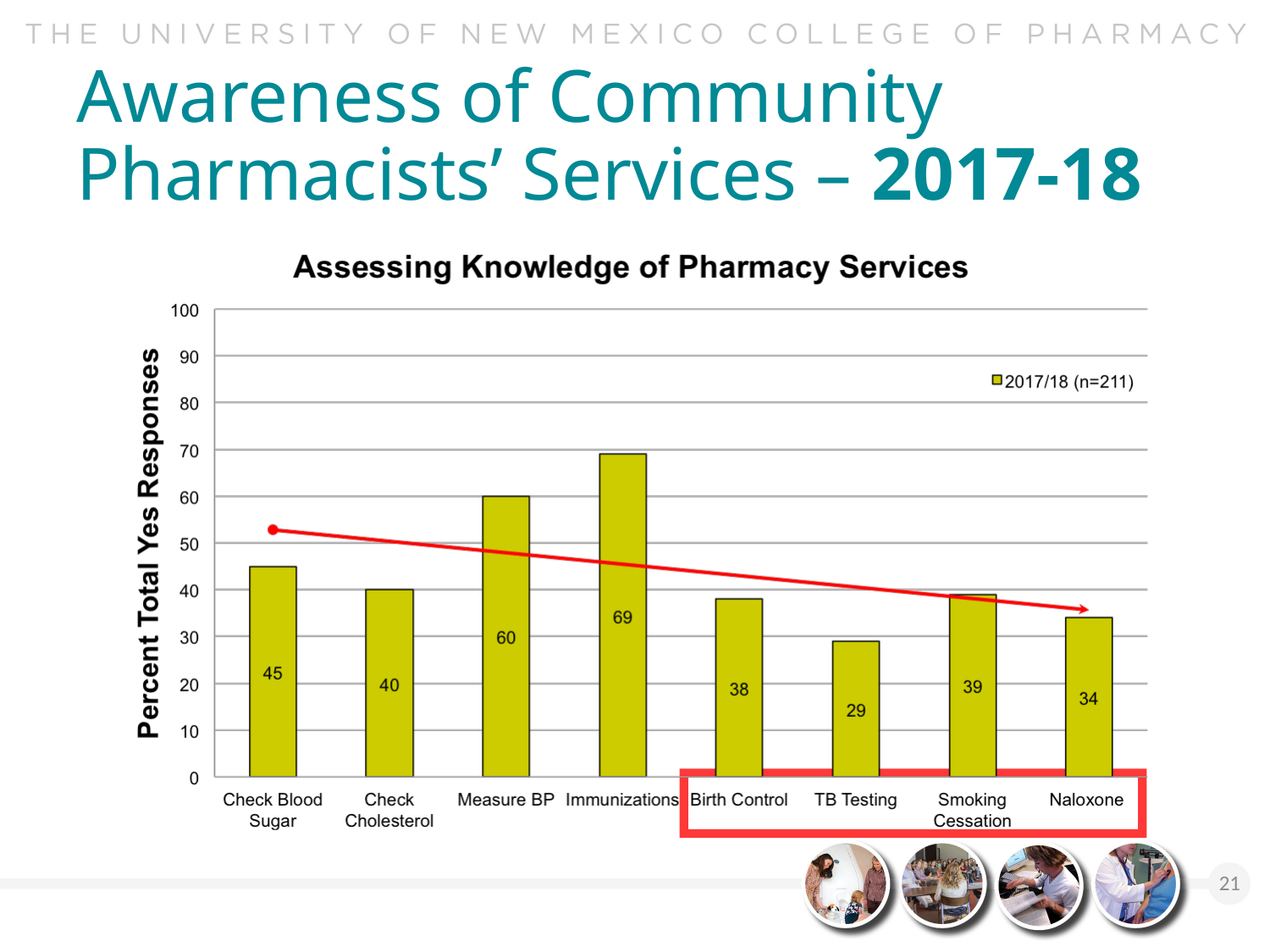
What is the difference between the values for Measure BP and Naloxone? 26 What is the value for Check Cholesterol? 40 Is the value for Birth Control greater or less than 40? less How many categories are shown on the x axis? 8 Which is larger, the value for Check Blood Sugar or the value for Smoking Cessation? Check Blood Sugar How many series does the legend list? 1 Which category has the lowest value? TB Testing What kind of chart is shown? bar chart What is the value for TB Testing? 29 Which category has the highest value? Immunizations What is the title of the chart? Assessing Knowledge of Pharmacy Services What is the value for Immunizations? 69